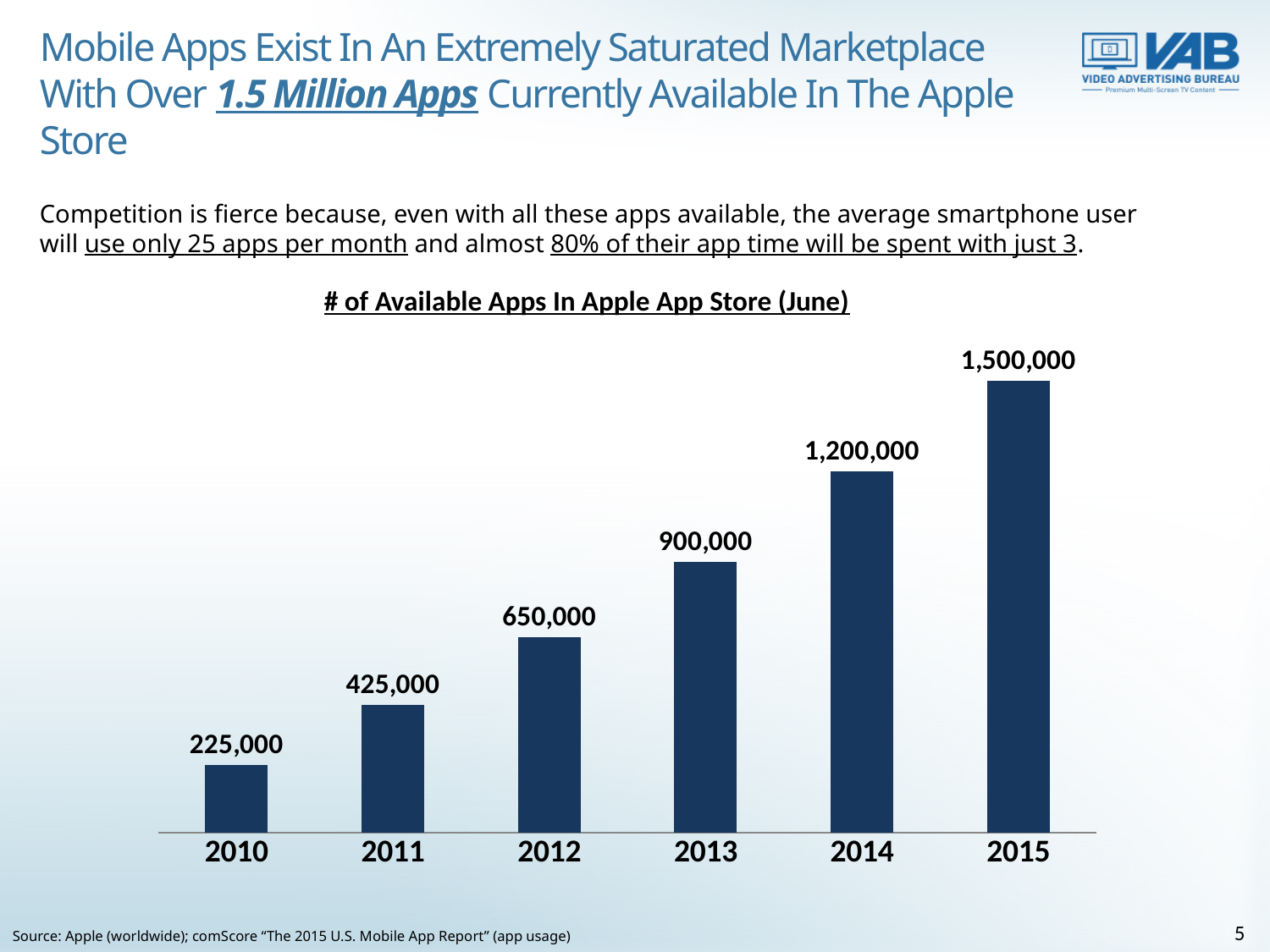
What is the title of the chart? # of Available Apps In Apple App Store (June) Which year has the lowest number of available apps? 2010 Which year has the highest number of available apps? 2015 How many years are shown on the chart? 6 What is the number of available apps in the Apple App Store in 2010? 225,000 What is the number of available apps in the Apple App Store in 2015? 1,500,000 Which year has more available apps, 2012 or 2013? 2013 What is the difference in available apps between 2012 and 2011? 225,000 Do the values rise or fall from 2010 to 2015? Rise What is the number of available apps in the Apple App Store in 2013? 900,000 What kind of chart is shown on the slide? Bar chart What is the difference in available apps between 2015 and 2014? 300,000